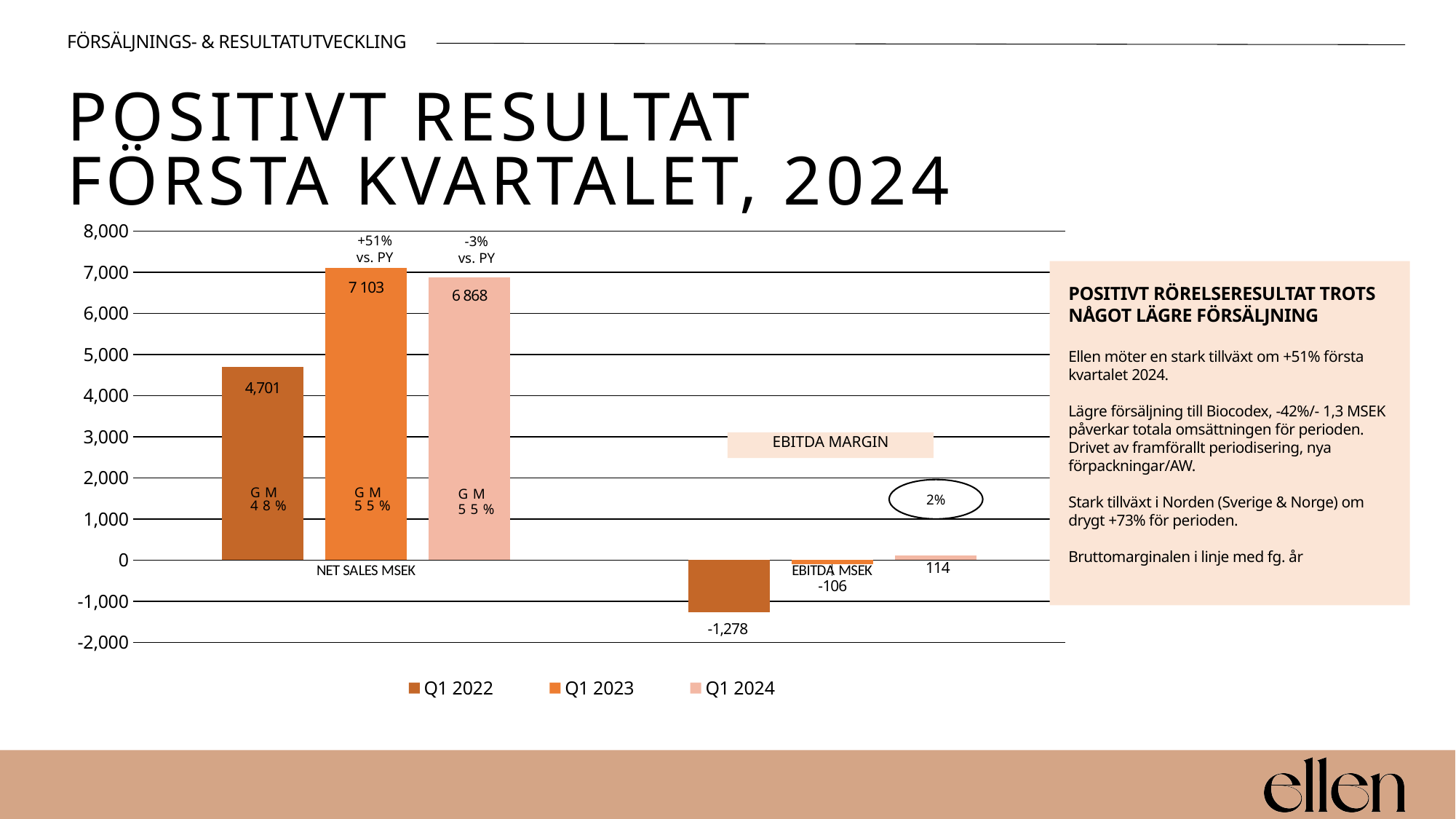
Which quarter has the lowest EBITDA MSEK? Q1 2022 What is the NET SALES MSEK value for Q1 2023? 7 103 Which quarter has the highest NET SALES MSEK? Q1 2023 What EBITDA margin is shown in the circle on the chart? 2% What type of chart is shown on the slide? bar chart What is the difference between EBITDA MSEK for Q1 2024 and Q1 2023? 220 What is the difference between NET SALES MSEK for Q1 2023 and Q1 2024? 235 Which is larger, NET SALES MSEK for Q1 2022 or for Q1 2024? Q1 2024 What is the EBITDA MSEK value for Q1 2024? 114 How many series does the legend list? 3 What is the EBITDA MSEK value for Q1 2022? -1,278 What is the NET SALES MSEK value for Q1 2022? 4,701